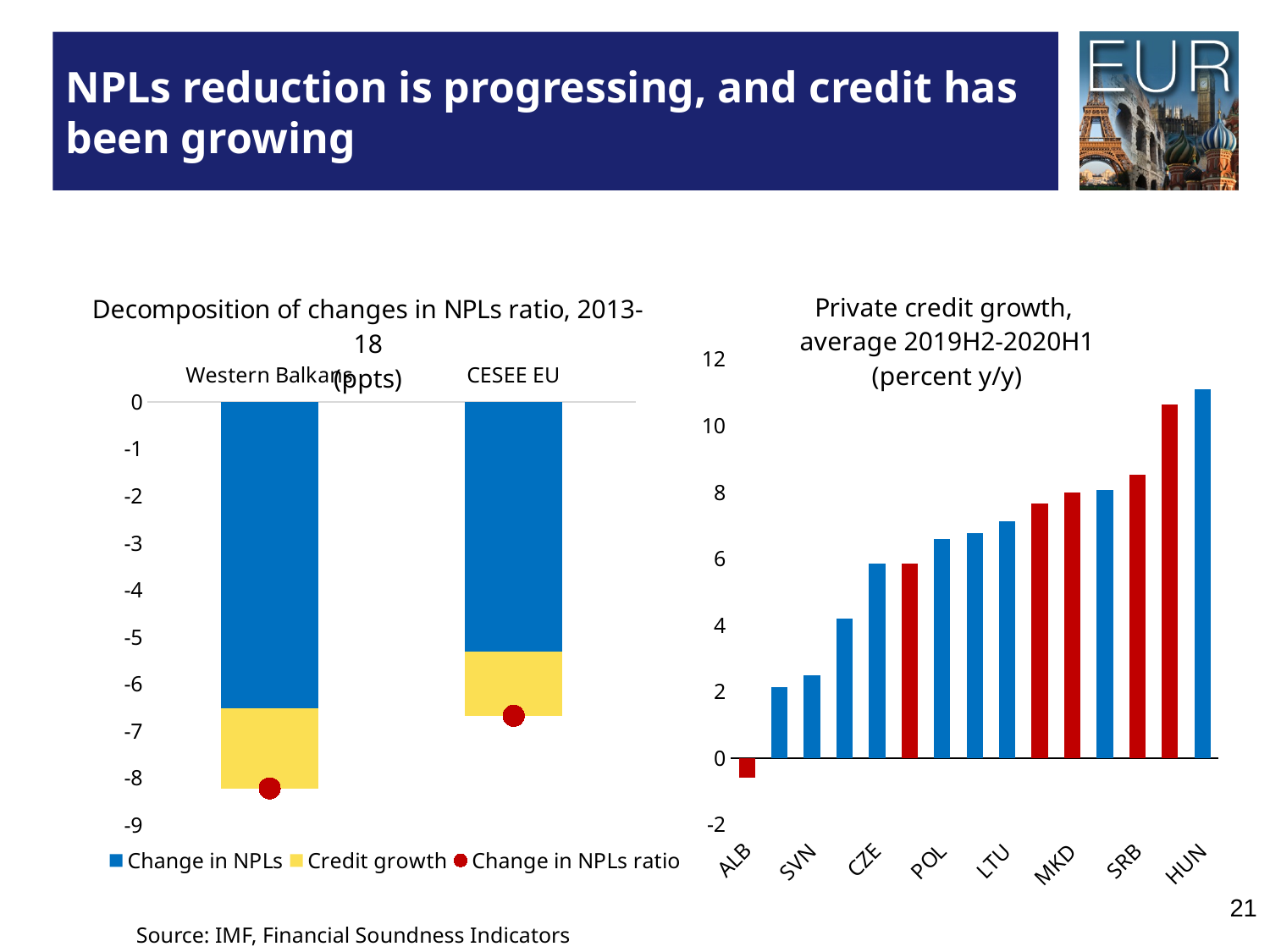
In the right chart ('Private credit growth, average 2019H2-2020H1'), do the values rise or fall moving from left to right along the x axis? rise How many series does the legend of the left chart ('Decomposition of changes in NPLs ratio') list? 3 How many categories are shown on the left chart ('Decomposition of changes in NPLs ratio')? 2 In the right chart ('Private credit growth, average 2019H2-2020H1'), which labelled country has the lowest value? ALB In the right chart ('Private credit growth, average 2019H2-2020H1'), which labelled country has the highest value? HUN In the right chart ('Private credit growth, average 2019H2-2020H1'), is the value for SVN greater or less than 4? less In the left chart ('Decomposition of changes in NPLs ratio'), which category shows the larger decline in the NPLs ratio, Western Balkans or CESEE EU? Western Balkans What kind of chart is the 'Decomposition of changes in NPLs ratio, 2013-18' chart on the left? bar chart In the right chart ('Private credit growth, average 2019H2-2020H1'), is the value for HUN greater or less than 10? greater In the left chart ('Decomposition of changes in NPLs ratio'), is the Change in NPLs ratio for Western Balkans greater or less than -7? less In the right chart ('Private credit growth, average 2019H2-2020H1'), what colour is the bar for ALB? red